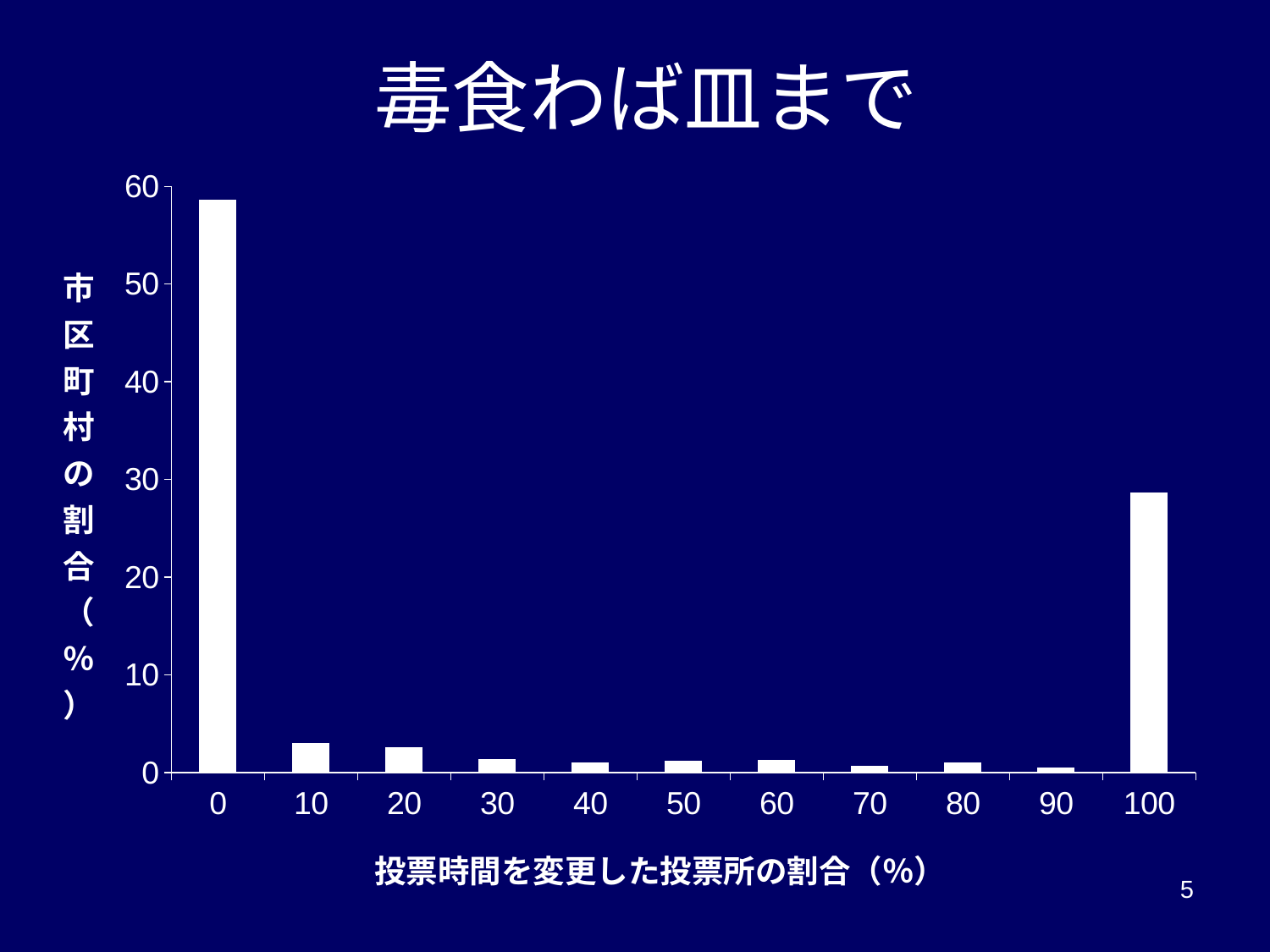
Is the value for the category 0 greater or less than 50? greater Which has the larger value, the category 10 or the category 90? 10 Which x-axis category has the highest bar? 0 Is the value for the category 10 greater or less than 10? less Which has the larger value, the category 0 or the category 100? 0 What kind of chart is shown on the slide? bar chart Is the value for the category 100 greater or less than 30? less Which has the larger value, the category 50 or the category 100? 100 How many categories are shown along the x axis of the chart? 11 What is the label of the x axis of the chart? 投票時間を変更した投票所の割合（%） What is the title of the slide above the chart? 毒食わば皿まで